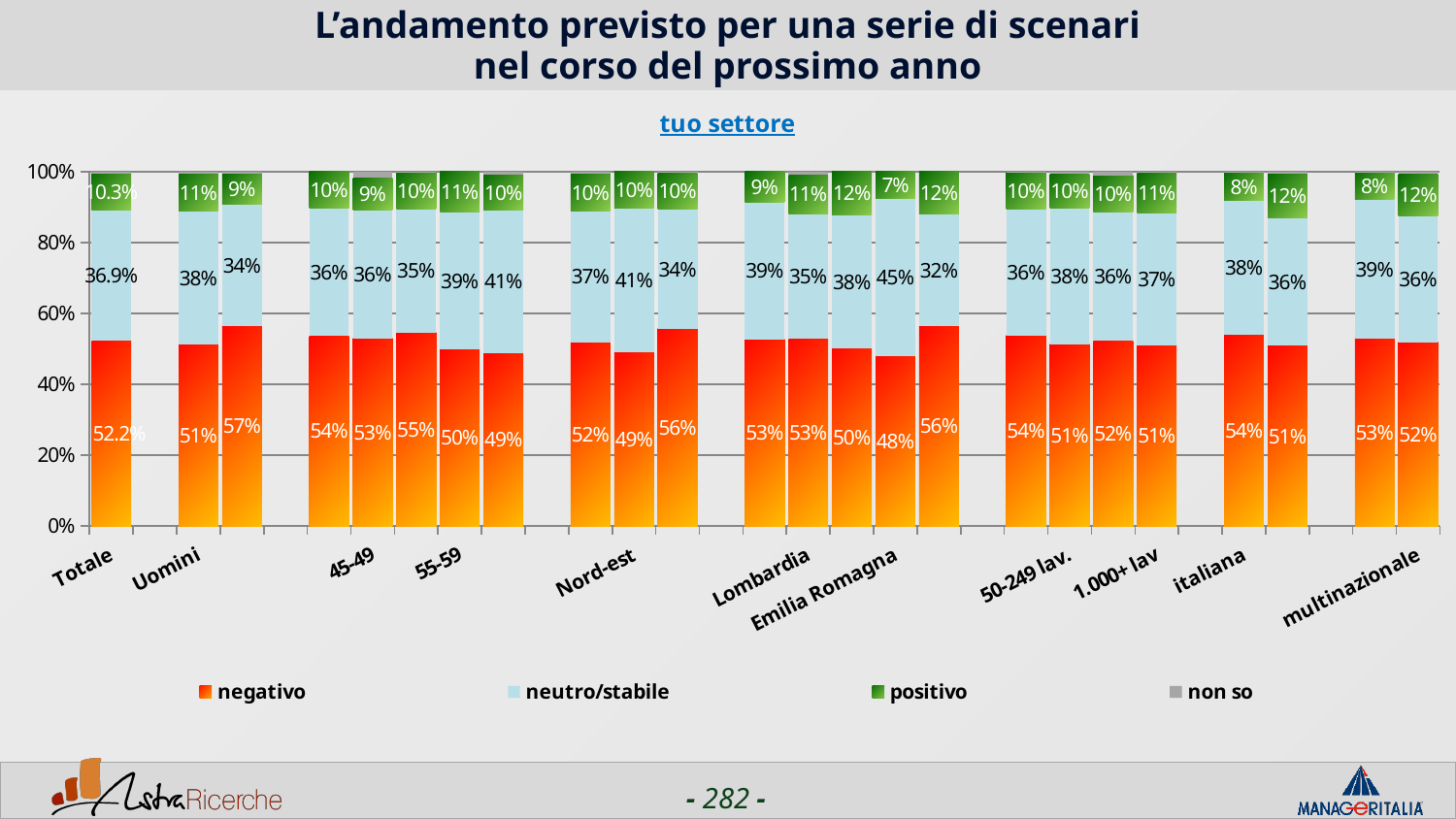
What kind of chart is shown on the slide? Stacked bar chart What is the 'negativo' value for the 45-49 group? 53% What is the difference between the 'negativo' and 'neutro/stabile' values for Totale? 15.3 percentage points What is the 'negativo' value for Totale? 52.2% How many series does the legend list? 4 Which has a larger 'negativo' value, italiana or Nord-est? italiana What is the 'positivo' value for Uomini? 11% What is the 'neutro/stabile' value for 50-249 lav.? 38% What is the 'negativo' value for Nord-est? 49% What is the 'neutro/stabile' value for the 55-59 group? 39% What is the 'positivo' value for Emilia Romagna? 7% What is the 'neutro/stabile' value for Totale? 36.9%